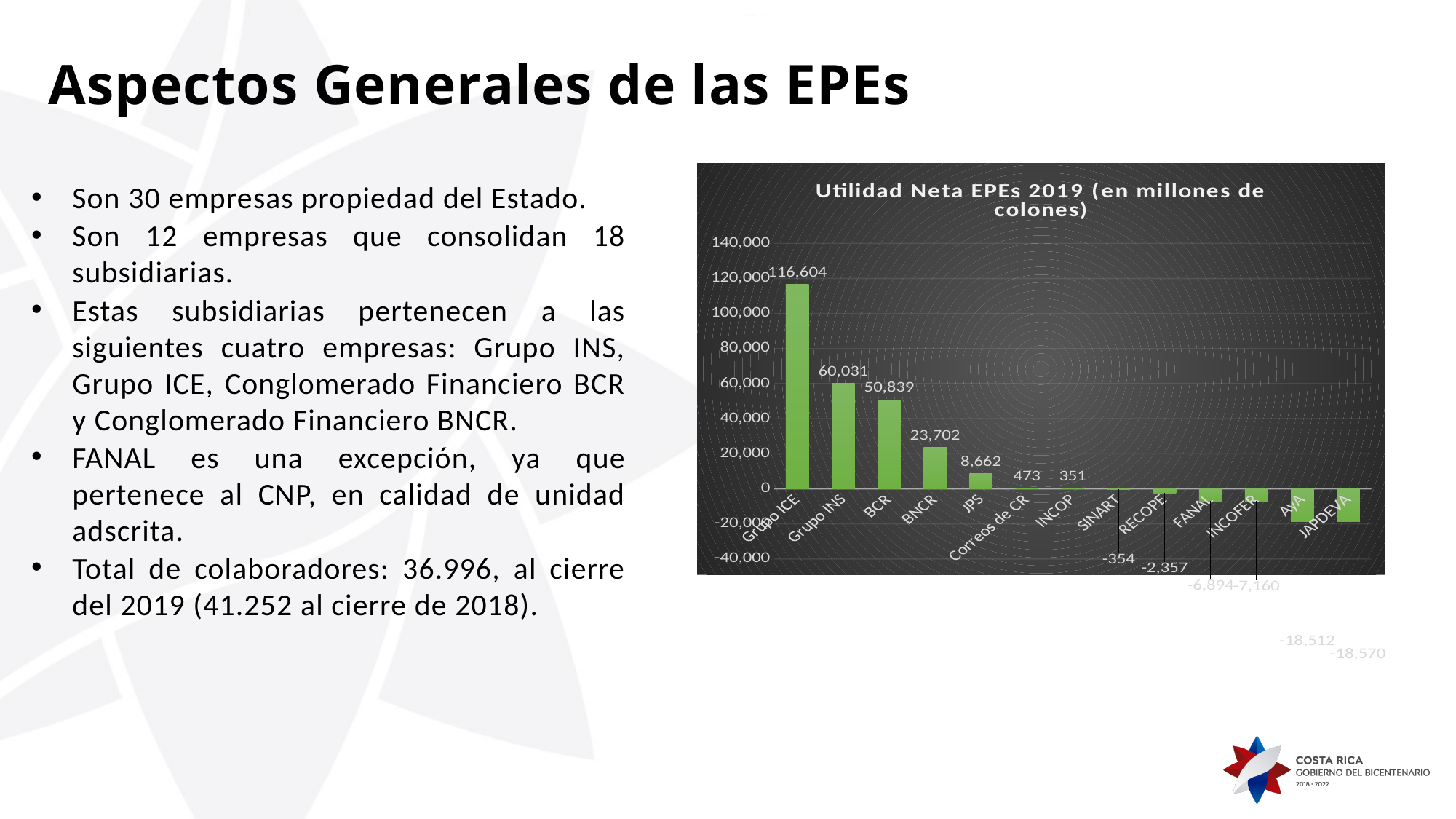
Which is larger, the value for BNCR or the value for JPS? BNCR What is the value shown for Grupo ICE? 116,604 What is the difference between the values for Grupo ICE and Grupo INS? 56,573 What is the title of the chart? Utilidad Neta EPEs 2019 (en millones de colones) What is the value shown for RECOPE? -2,357 What is the value shown for JPS? 8,662 Which company has the highest net profit in the chart? Grupo ICE What kind of chart is shown on the slide? bar chart What is the difference between the values for Grupo INS and BCR? 9,192 How many companies are shown on the x axis of the chart? 13 What is the value shown for BCR? 50,839 What is the value shown for Correos de CR? 473